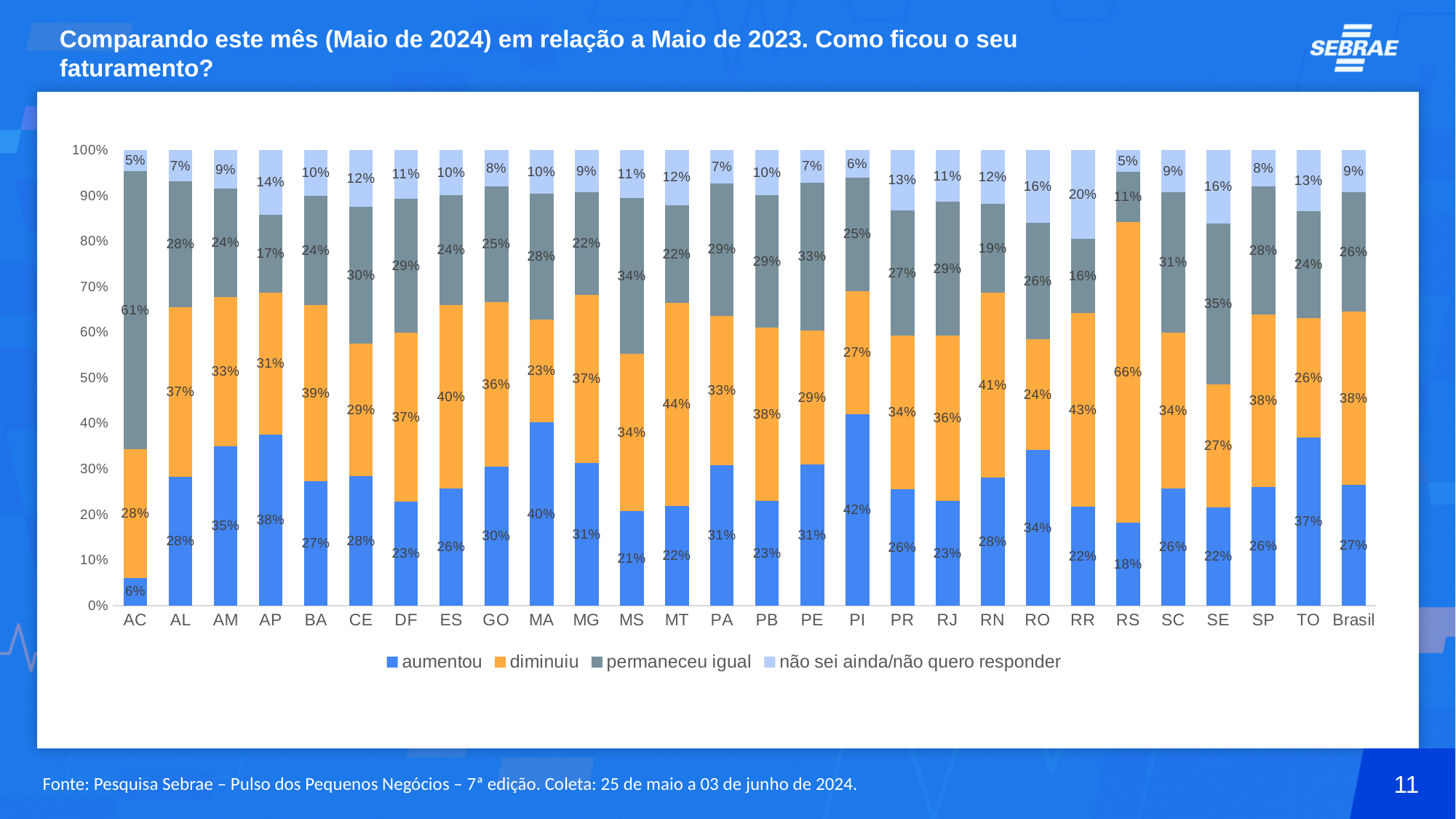
What is the difference between the "diminuiu" values for RS and Brasil? 28% Which is larger, the "aumentou" value for MA or for TO? MA What is the "permaneceu igual" value for AC? 61% Which state has the lowest "aumentou" value? AC What kind of chart is shown on the slide? Stacked bar chart Which state has the highest "não sei ainda/não quero responder" value? RR Which state has the highest "aumentou" value? PI How many series does the legend list? 4 What is the "diminuiu" value for RS? 66% How many categories are shown on the x axis? 28 What percentage of respondents in Brasil answered "aumentou"? 27% What colour represents the "diminuiu" series? Orange